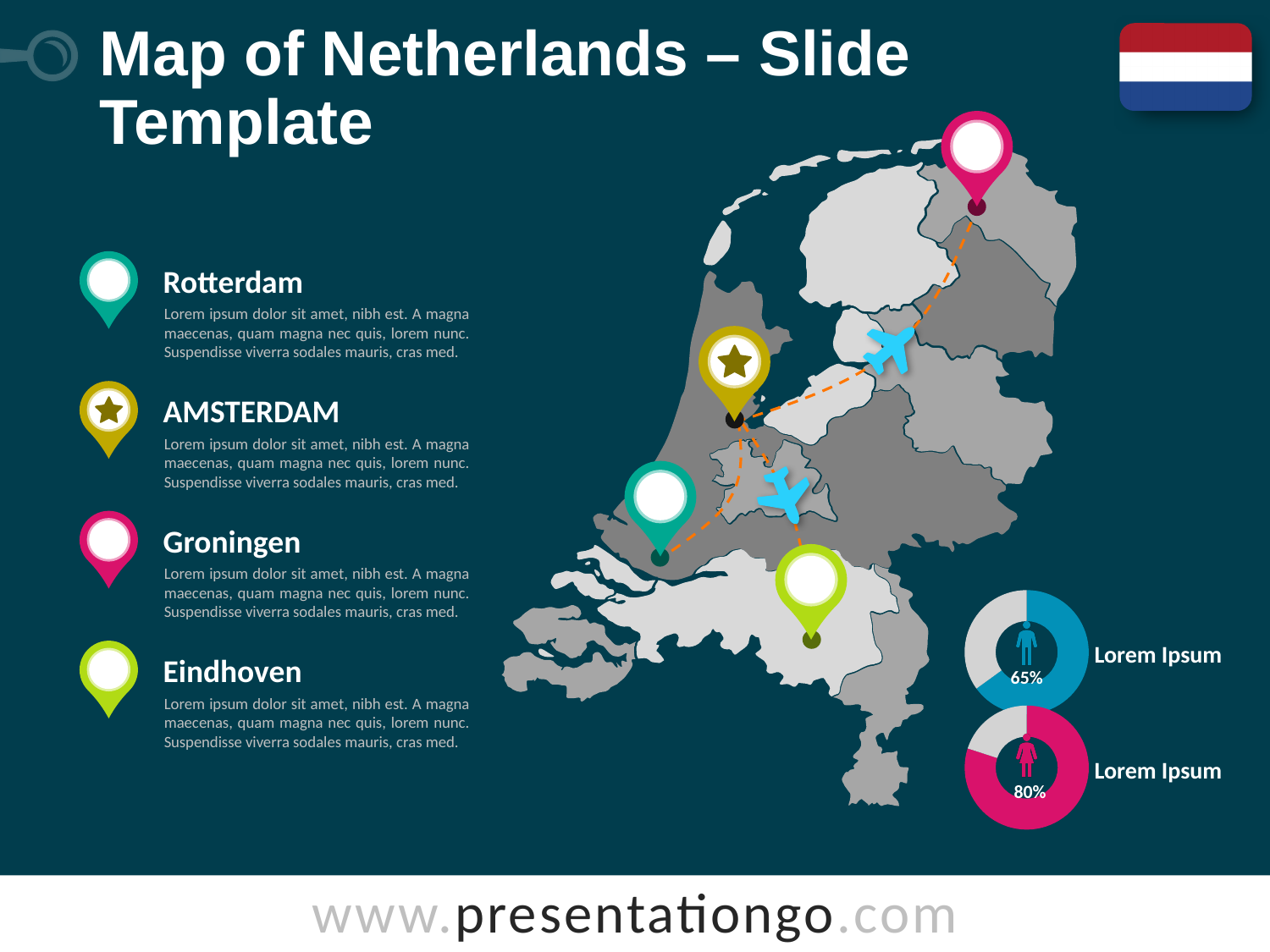
How many doughnut charts are shown on the slide? 2 What percentage is shown in the lower (pink) doughnut chart on the right of the map? 80% Which doughnut chart shows the lowest value? the upper blue one (65%) What kind of chart are the two small charts at the bottom right of the map? doughnut chart What colour is the filled portion of the doughnut chart showing 80%? pink What label appears to the right of each doughnut chart? Lorem Ipsum What percentage is shown in the upper (blue) doughnut chart on the right of the map? 65% Which of the two doughnut charts shows the larger value, the upper blue one or the lower pink one? the lower pink one What is the difference between the value in the lower pink doughnut chart and the value in the upper blue doughnut chart? 15%